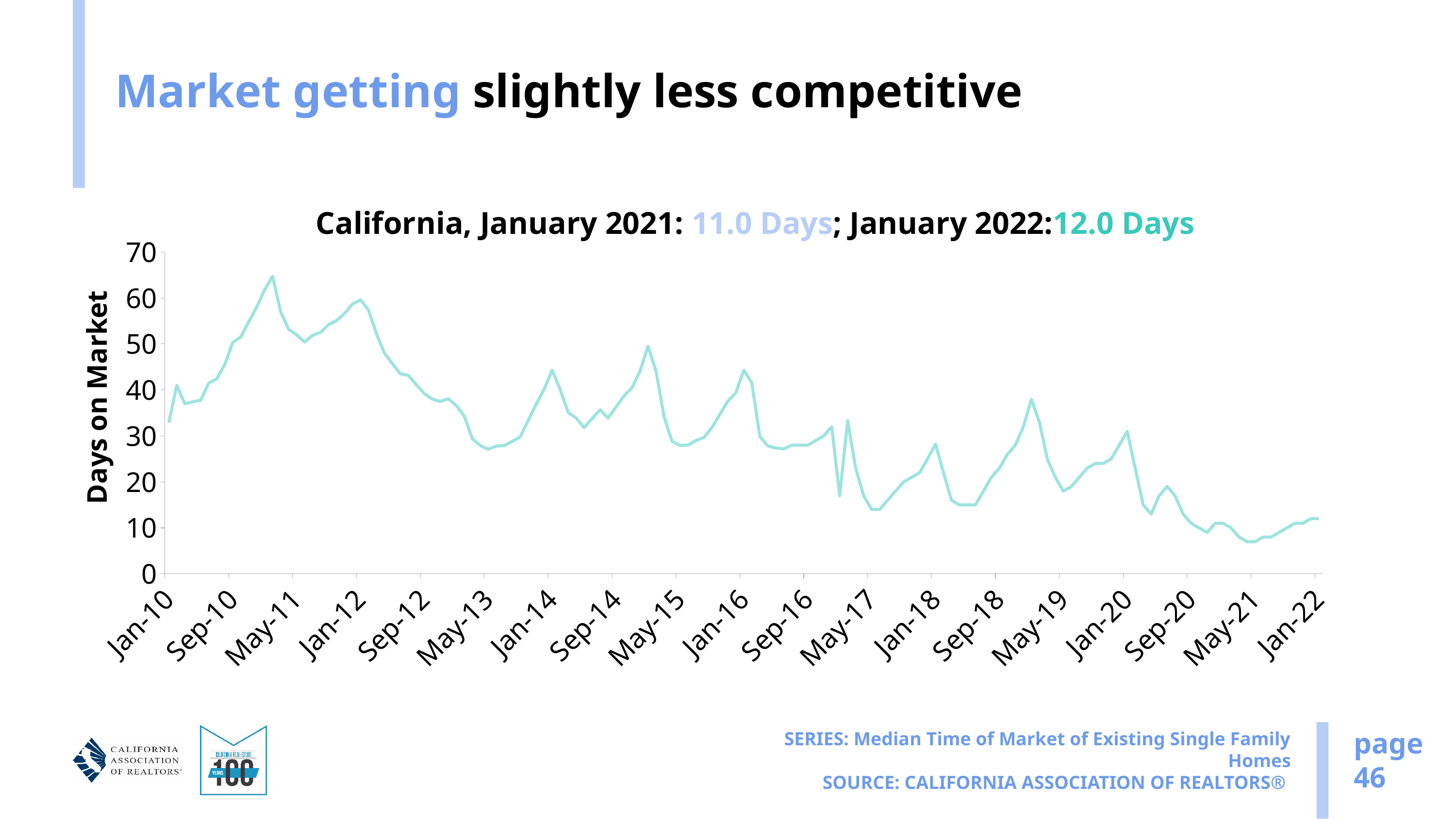
Is the value at May-17 greater or less than 20? less What is the label on the vertical axis? Days on Market In which year does the line reach its highest value? 2011 How many lines are plotted on the chart? 1 Overall, do the days on market rise or fall from Jan-10 to Jan-22? Fall Is the value at May-21 greater or less than 10? less What was the median days on market for California in January 2022, according to the chart title? 12.0 Days By how many days did the January value change from January 2021 to January 2022? 1.0 Days Is the value at May-11 greater or less than 60? less Which is larger, the January 2021 value or the January 2022 value? January 2022 What kind of chart is shown on the slide? Line chart What was the median days on market for California in January 2021, according to the chart title? 11.0 Days